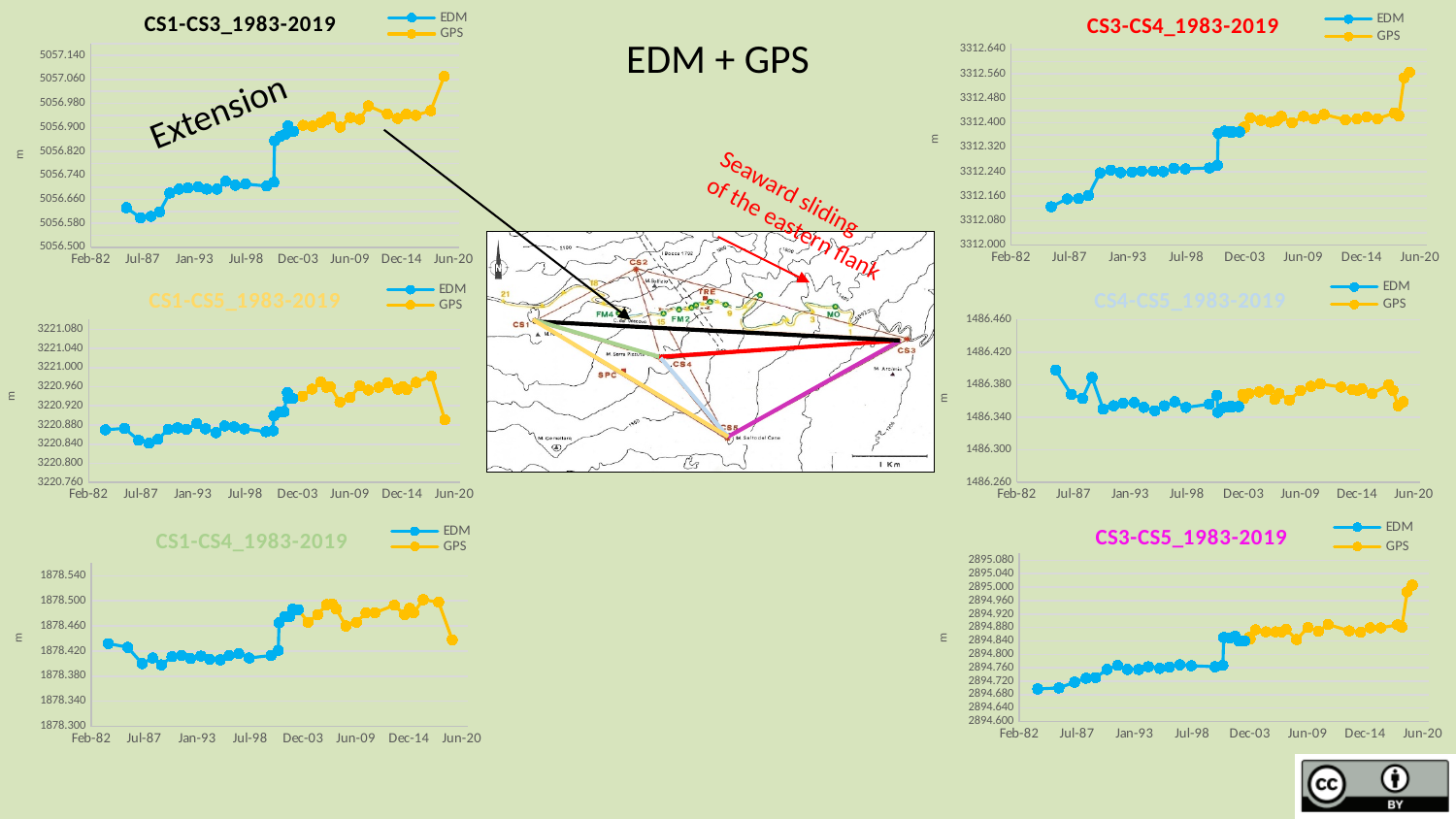
How many line charts are shown on the slide? 6 In the CS3-CS5_1983-2019 chart, do the values generally rise or fall from Feb-82 to Jun-20? rise In the CS1-CS3_1983-2019 chart, is the last GPS value (at Jun-20) greater or less than 5056.900? greater In the CS3-CS4_1983-2019 chart, do the values generally rise or fall from Feb-82 to Jun-20? rise In the CS3-CS4_1983-2019 chart, is the last GPS value (at Jun-20) greater or less than 3312.400? greater In the CS4-CS5_1983-2019 chart, are the plotted values greater or less than 1486.420? less What kind of chart is the CS1-CS3_1983-2019 chart? line chart What are the two series named in the legend of the CS1-CS5_1983-2019 chart? EDM and GPS How many series does the legend of the CS3-CS4_1983-2019 chart list? 2